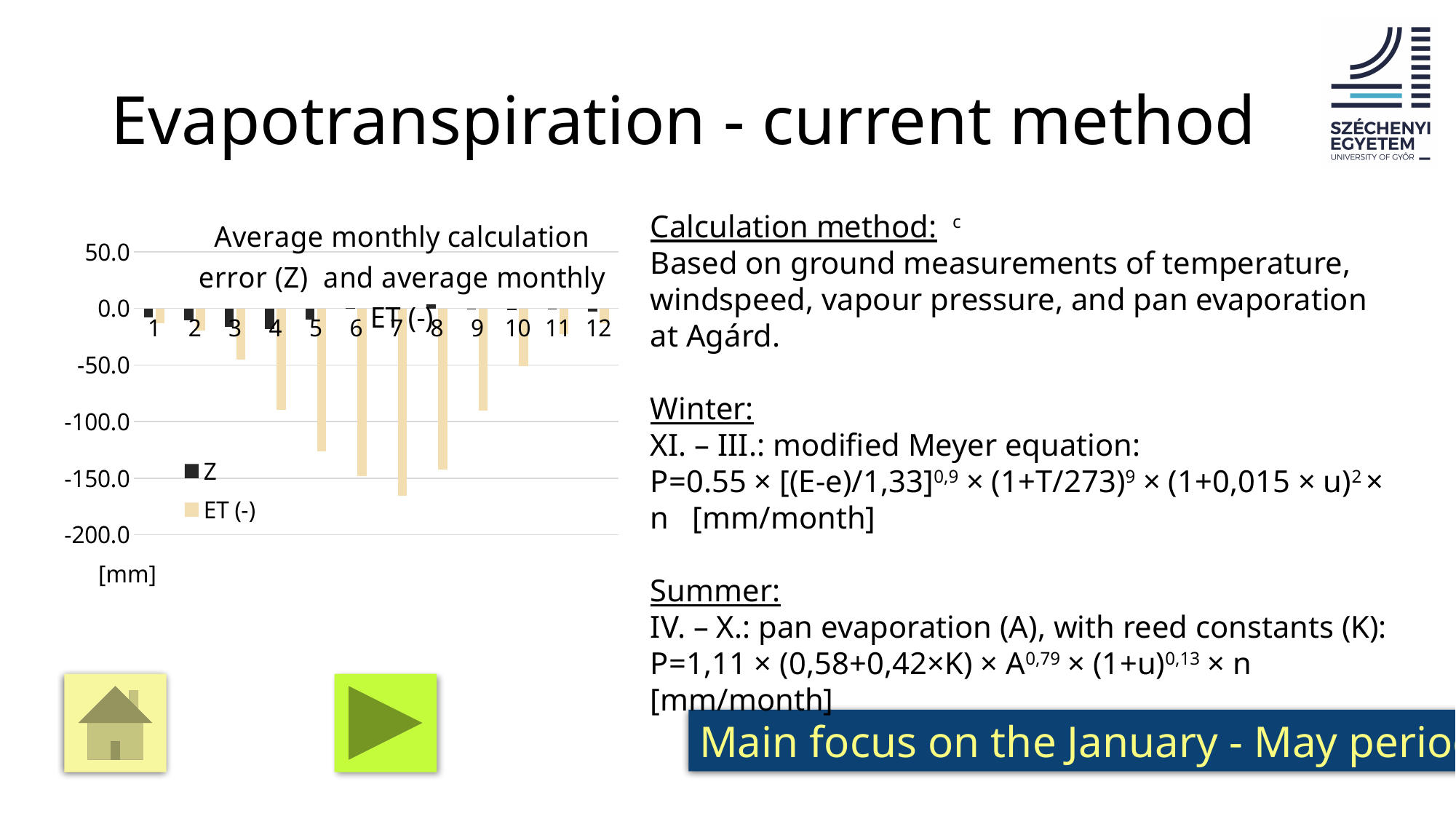
Is the ET (-) value for month 2 greater or less than -50.0? greater How many series does the chart legend list? 2 How many months (categories) are plotted along the x axis of the chart? 12 Is the ET (-) value for month 6 greater or less than -100.0? less What are the two series named in the chart legend? Z and ET (-) Is the ET (-) value for month 5 greater or less than -100.0? less Which month has the longer ET (-) bar, month 7 or month 4? 7 Which month has the lowest (most negative) ET (-) value in the chart? 7 What kind of chart is shown on the slide? bar chart What unit label is shown below the vertical axis of the chart? [mm]